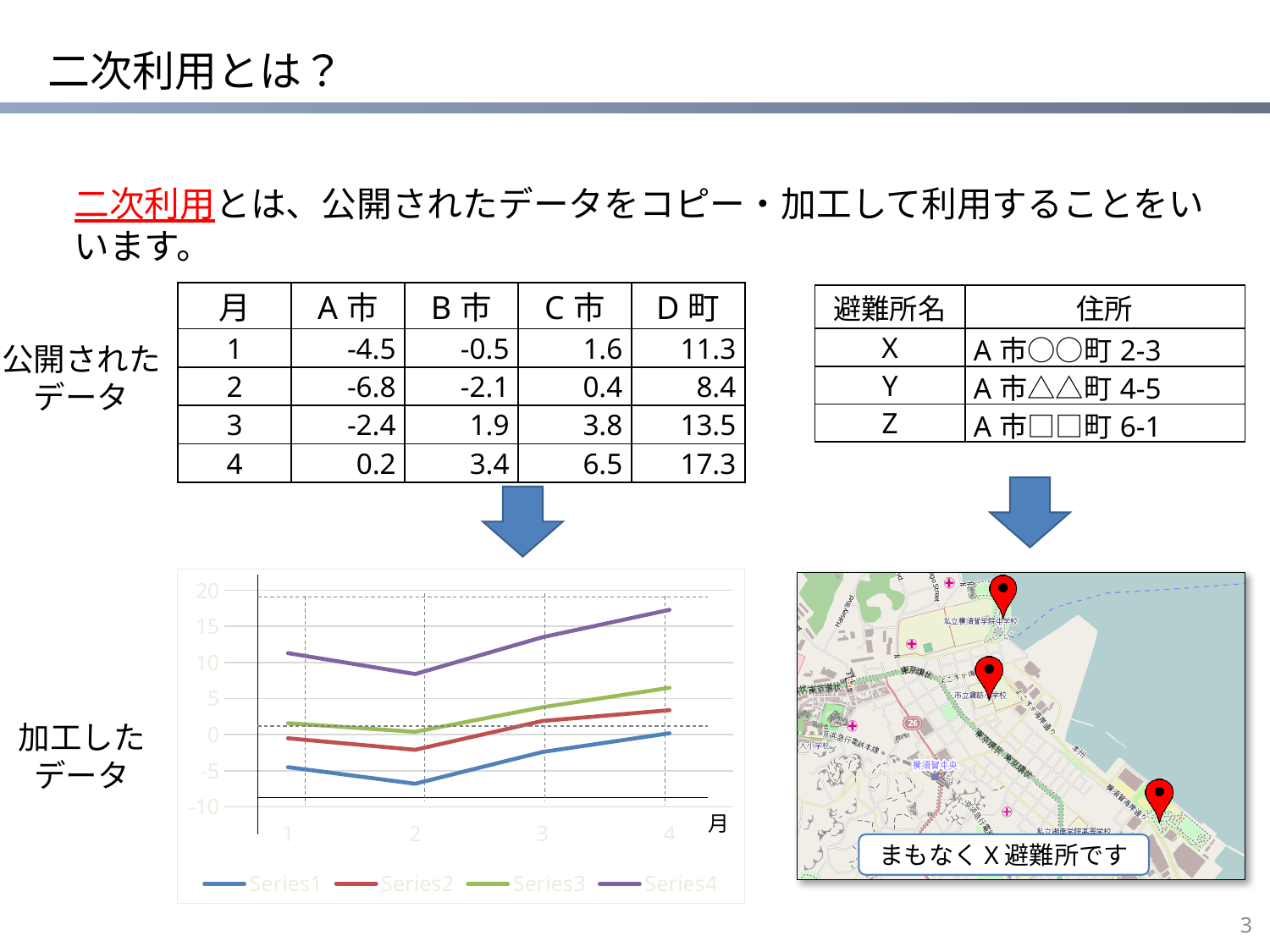
How many series does the chart's legend list? 4 Is the value of Series1 at x = 2 greater or less than -5? less Is the value of Series4 at x = 4 greater or less than 15? greater How many points along the x axis does each series in the chart have? 4 What kind of chart is shown on the slide? line chart Which series has the highest value at x = 4 in the chart? Series4 Which series has the lowest value at x = 2 in the chart? Series1 Is the value of Series3 at x = 1 greater or less than 0? greater What is the label on the x axis of the chart? 月 At x = 3, which is larger in the chart: Series2 or Series3? Series3 Does Series4 rise or fall from x = 2 to x = 4 in the chart? rise What are the legend entries of the chart? Series1, Series2, Series3, Series4